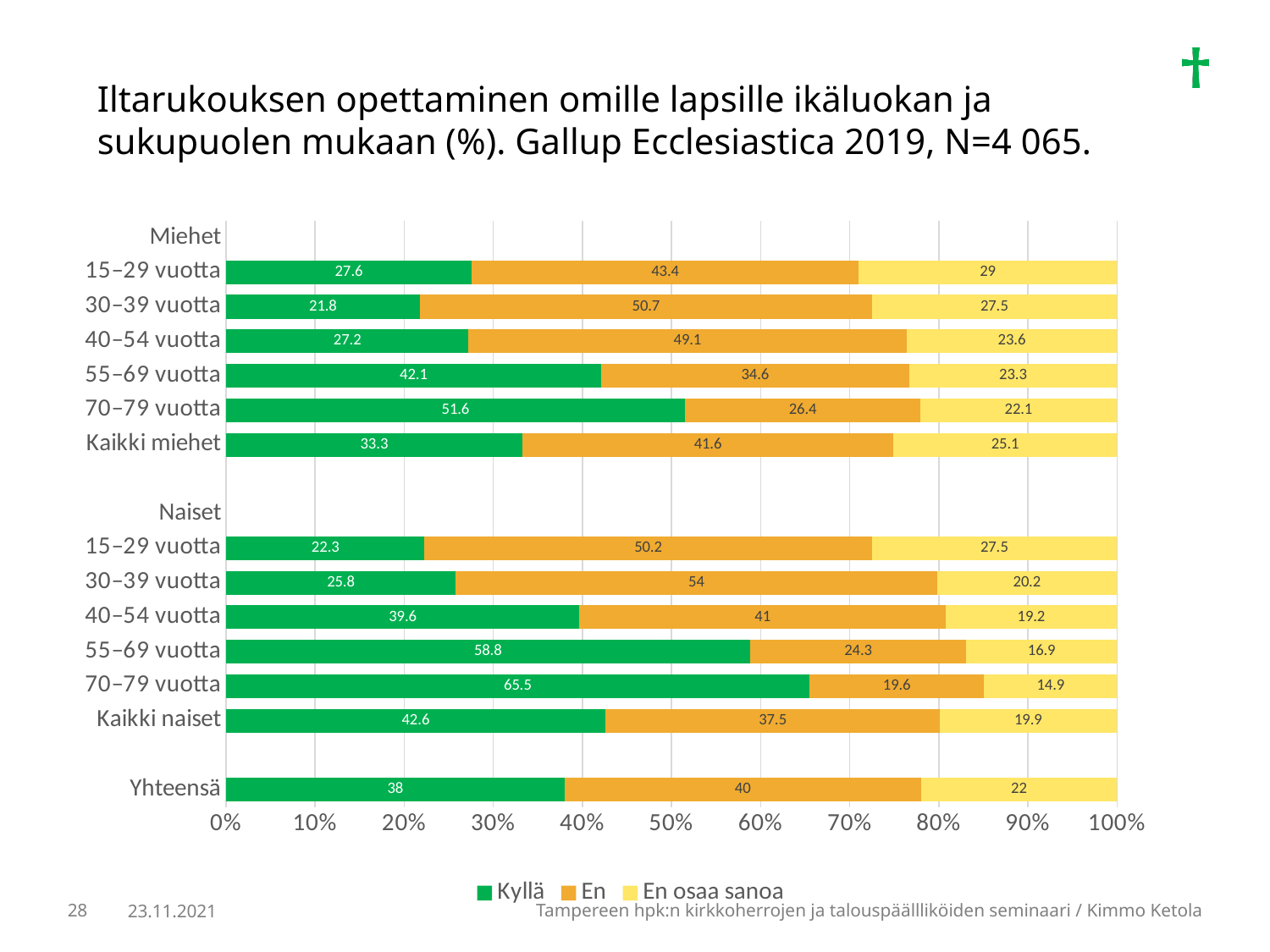
What is the En osaa sanoa value for Yhteensä? 22 What is the Kyllä value for Miehet 15–29 vuotta? 27.6 What is the En value for Naiset 30–39 vuotta? 54 Which is larger, the En value for Miehet 40–54 vuotta or the En value for Naiset 40–54 vuotta? Miehet 40–54 vuotta Which category has the highest Kyllä value? Naiset 70–79 vuotta How many series does the legend list? 3 What kind of chart is shown on the slide? Stacked bar chart Is the Kyllä value for Yhteensä greater or less than 40%? less What is the difference between the Kyllä values for Kaikki naiset and Kaikki miehet? 9.3 Which category has the lowest Kyllä value? Miehet 30–39 vuotta Among the Naiset age groups from 15–29 vuotta to 70–79 vuotta, does the Kyllä value rise or fall with age? rise What is the total of the three segments in the Yhteensä bar? 100